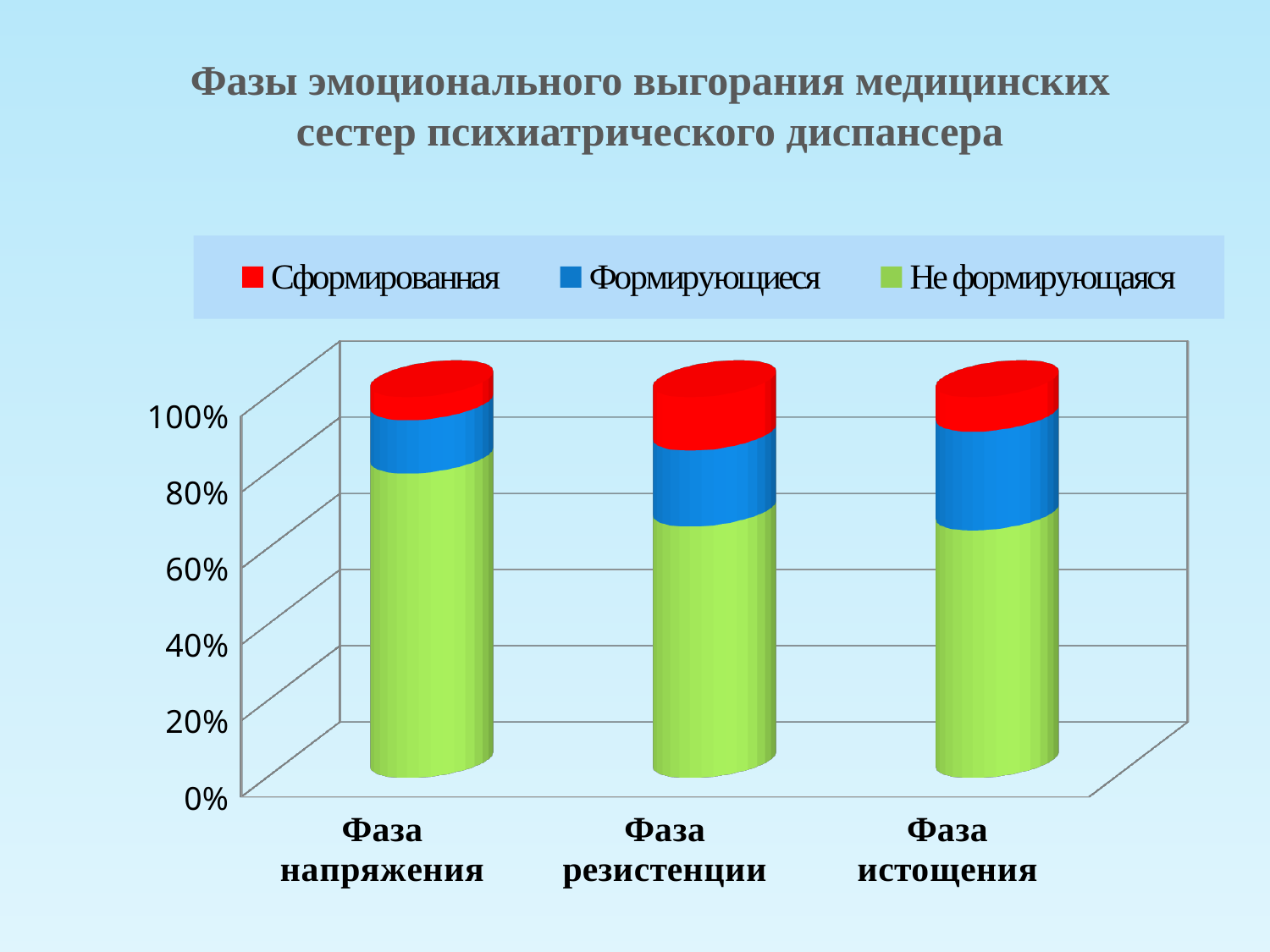
How many series does the legend list? 3 What is the total height of each stacked bar on the percentage axis? 100% Which phase has the largest 'Сформированная' share? Фаза резистенции What kind of chart is shown on the slide? Stacked bar chart Is the 'Не формирующаяся' share for Фаза истощения greater or less than 80%? less What is the title of the chart on the slide? Фазы эмоционального выгорания медицинских сестер психиатрического диспансера Which phase has the largest 'Не формирующаяся' share? Фаза напряжения Is the 'Не формирующаяся' share for Фаза резистенции greater or less than 80%? less How many phases (categories) are shown on the x axis? 3 Is the 'Сформированная' share larger for Фаза резистенции or for Фаза напряжения? Фаза резистенции Which series is shown in red in the legend? Сформированная